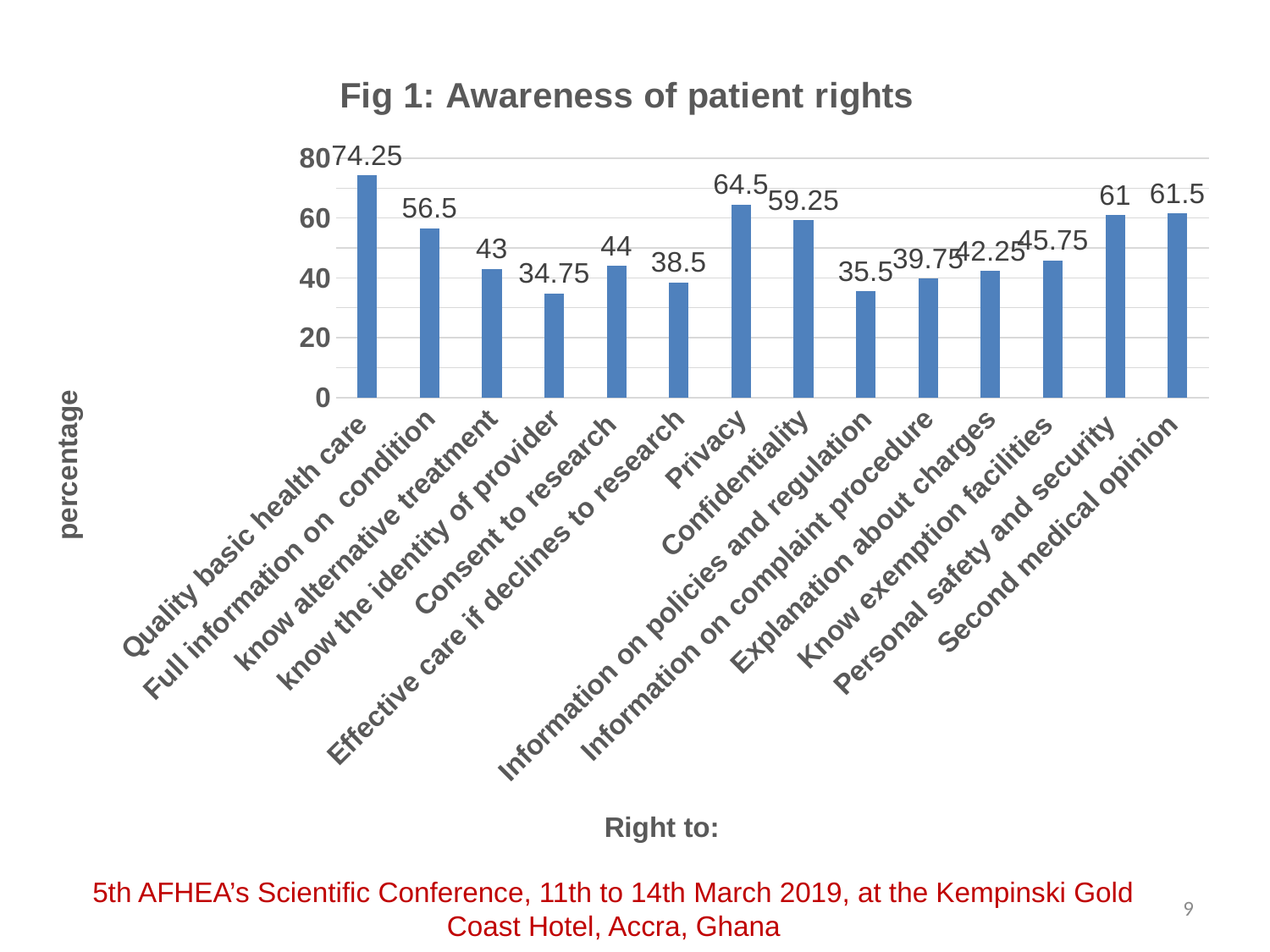
What is the value for Privacy? 64.5 Which category has the highest value? Quality basic health care What is the difference between the values for Privacy and Confidentiality? 5.25 What is the value for Second medical opinion? 61.5 Which category has the lowest value? know the identity of provider What is the value for Know exemption facilities? 45.75 What is the title of the chart? Fig 1: Awareness of patient rights Is the value for Full information on condition greater or less than 60? less What is the value for Quality basic health care? 74.25 How many categories are shown on the x axis? 14 What kind of chart is shown on the slide? bar chart Which is larger, the value for Consent to research or the value for Effective care if declines to research? Consent to research